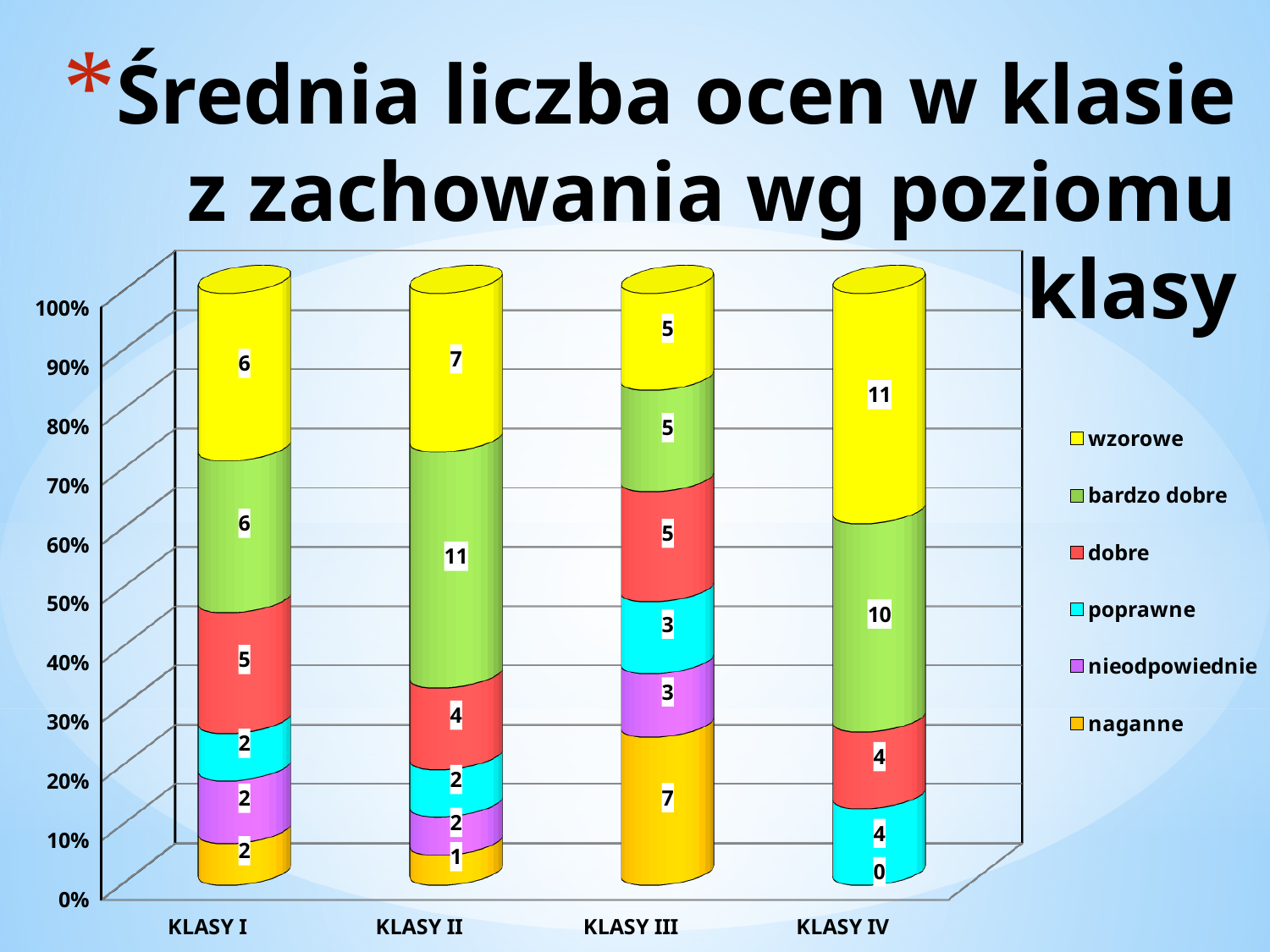
What is the value for 'naganne' in KLASY III? 7 What is the total of all segments in the KLASY I bar? 23 What type of chart is shown on the slide? stacked bar chart What is the value for 'dobre' in KLASY I? 5 How many class categories are shown on the x axis? 4 Which class has the highest value for 'wzorowe'? KLASY IV Which is larger: the 'naganne' value for KLASY III or for KLASY I? KLASY III How many series does the legend list? 6 What is the value for 'bardzo dobre' in KLASY II? 11 What is the difference between the 'bardzo dobre' values for KLASY II and KLASY I? 5 What is the value for 'wzorowe' in KLASY IV? 11 Which class has the lowest value for 'naganne' among KLASY I, II and III? KLASY II